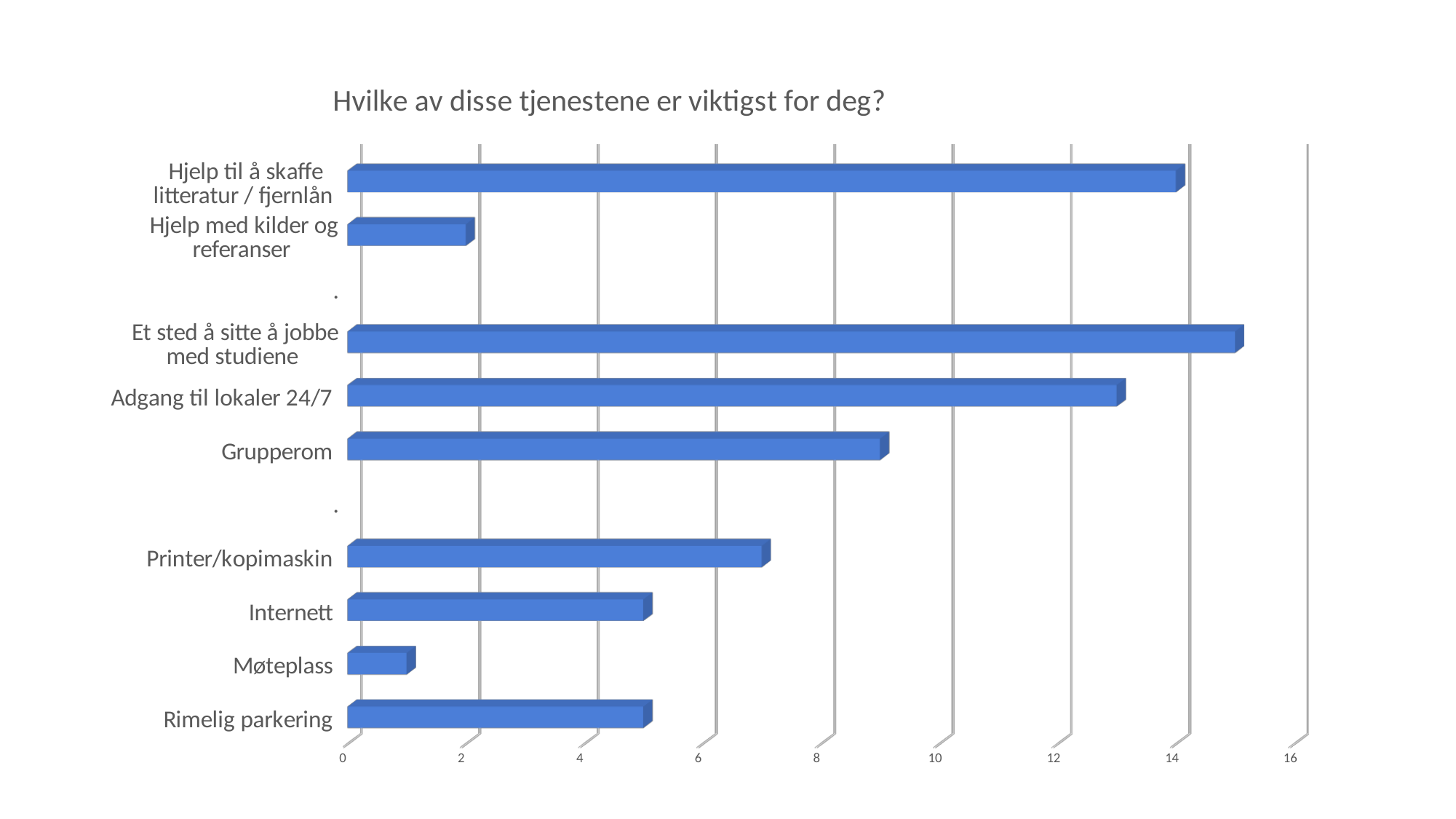
What type of chart is shown on the slide? bar chart Which category has the lowest value? Møteplass How many bars are plotted in the chart? 9 Which is larger, the value for Hjelp til å skaffe litteratur / fjernlån or the value for Hjelp med kilder og referanser? Hjelp til å skaffe litteratur / fjernlån Is the value for Printer/kopimaskin greater or less than 8? less What is the title of the chart? Hvilke av disse tjenestene er viktigst for deg? Which is larger, the value for Adgang til lokaler 24/7 or the value for Grupperom? Adgang til lokaler 24/7 Is the value for Internett greater or less than 6? less Which category has the highest value? Et sted å sitte å jobbe med studiene Is the value for Adgang til lokaler 24/7 greater or less than 12? greater